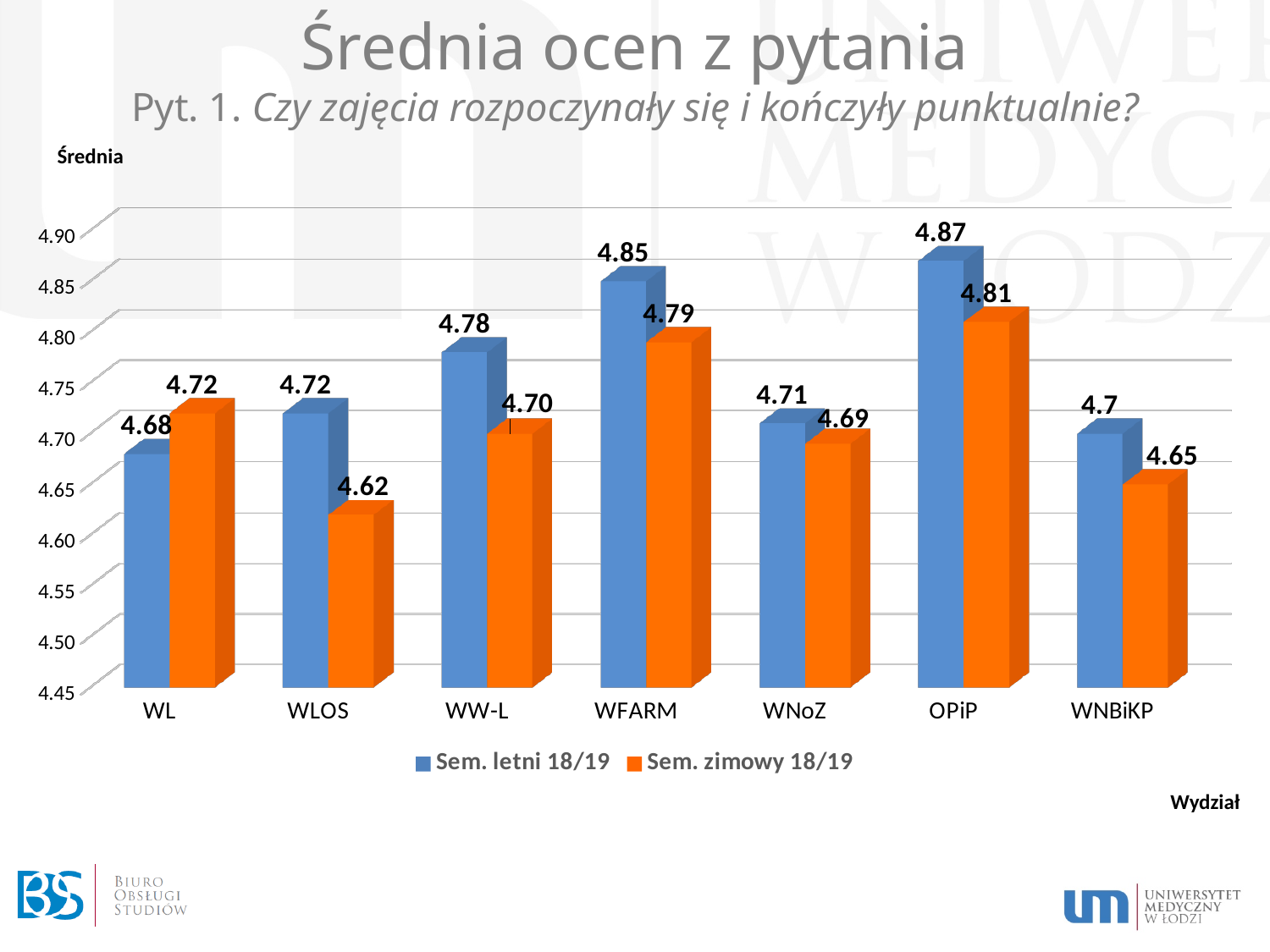
How many series does the legend list? 2 What colour represents the Sem. zimowy 18/19 series? Orange What kind of chart is shown on the slide? Bar chart How many faculties are shown on the x axis? 7 What is the difference between the Sem. letni 18/19 and Sem. zimowy 18/19 values for WLOS? 0.10 What is the value for WNBiKP in the Sem. letni 18/19 series? 4.7 Which faculty has the lowest value in the Sem. zimowy 18/19 series? WLOS What is the value for WLOS in the Sem. zimowy 18/19 series? 4.62 Which faculty has the highest value in the Sem. letni 18/19 series? OPiP For WL, which series has the larger value: Sem. letni 18/19 or Sem. zimowy 18/19? Sem. zimowy 18/19 What is the difference between the Sem. letni 18/19 values for OPiP and WL? 0.19 What is the value for WFARM in the Sem. letni 18/19 series? 4.85